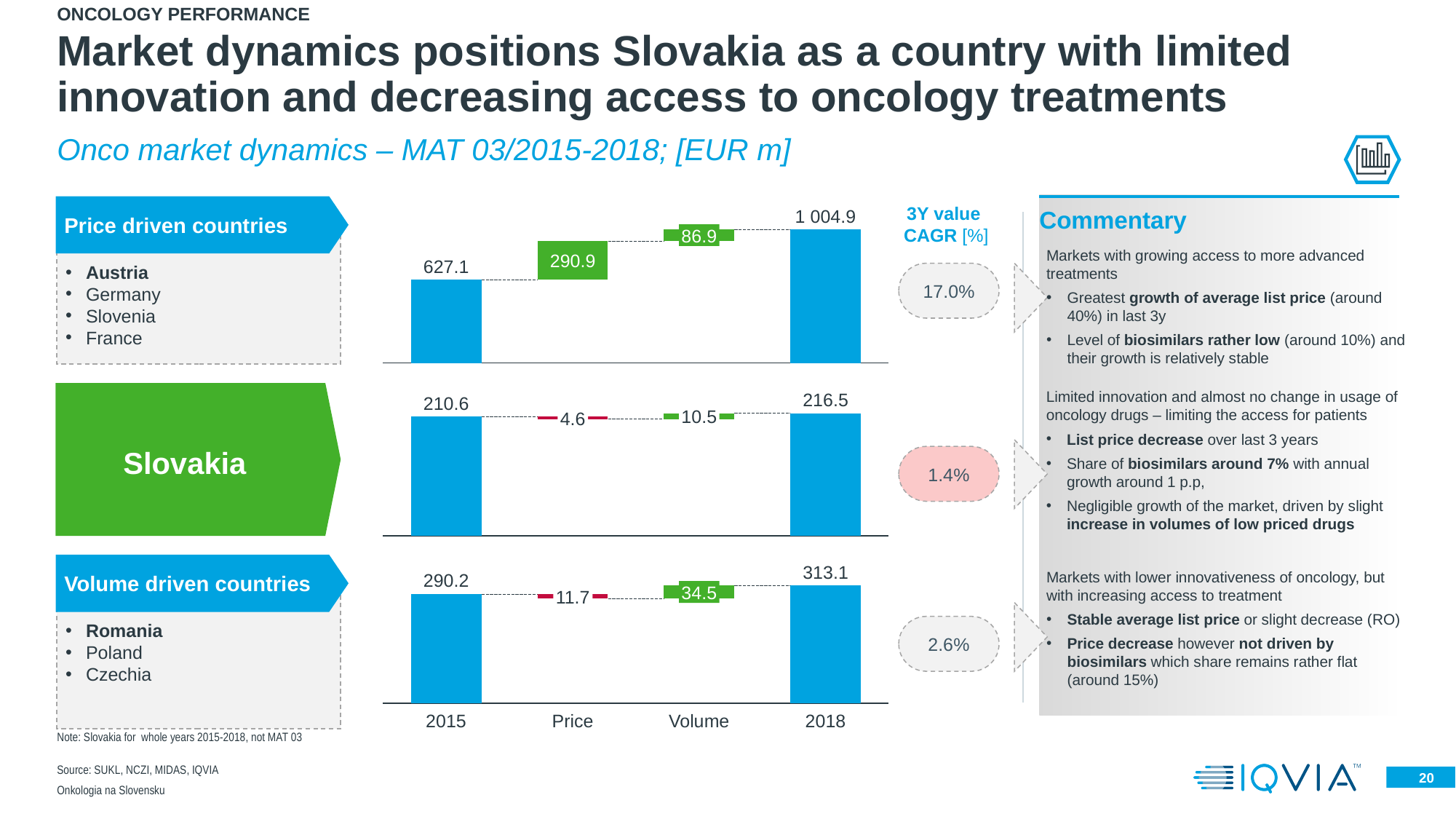
In the Price driven countries chart, what is the 2018 value? 1 004.9 In the Volume driven countries chart, what is the Price effect value? 11.7 In the Price driven countries chart, what is the 2015 value? 627.1 In the Price driven countries chart, what is the difference between the 2018 and 2015 values? 377.8 In the Slovakia chart, what is the difference between the 2018 and 2015 values? 5.9 Which chart shows the highest 3Y value CAGR: Price driven countries, Slovakia, or Volume driven countries? Price driven countries In the Price driven countries chart, what is the Price effect value? 290.9 In the Slovakia chart, what is the 2018 value? 216.5 In the Volume driven countries chart, what is the 2018 value? 313.1 In the Slovakia chart, what is the Volume effect value? 10.5 In the Volume driven countries chart, which is larger, the Price effect or the Volume effect? Volume effect What is the 3Y value CAGR shown for Slovakia? 1.4%